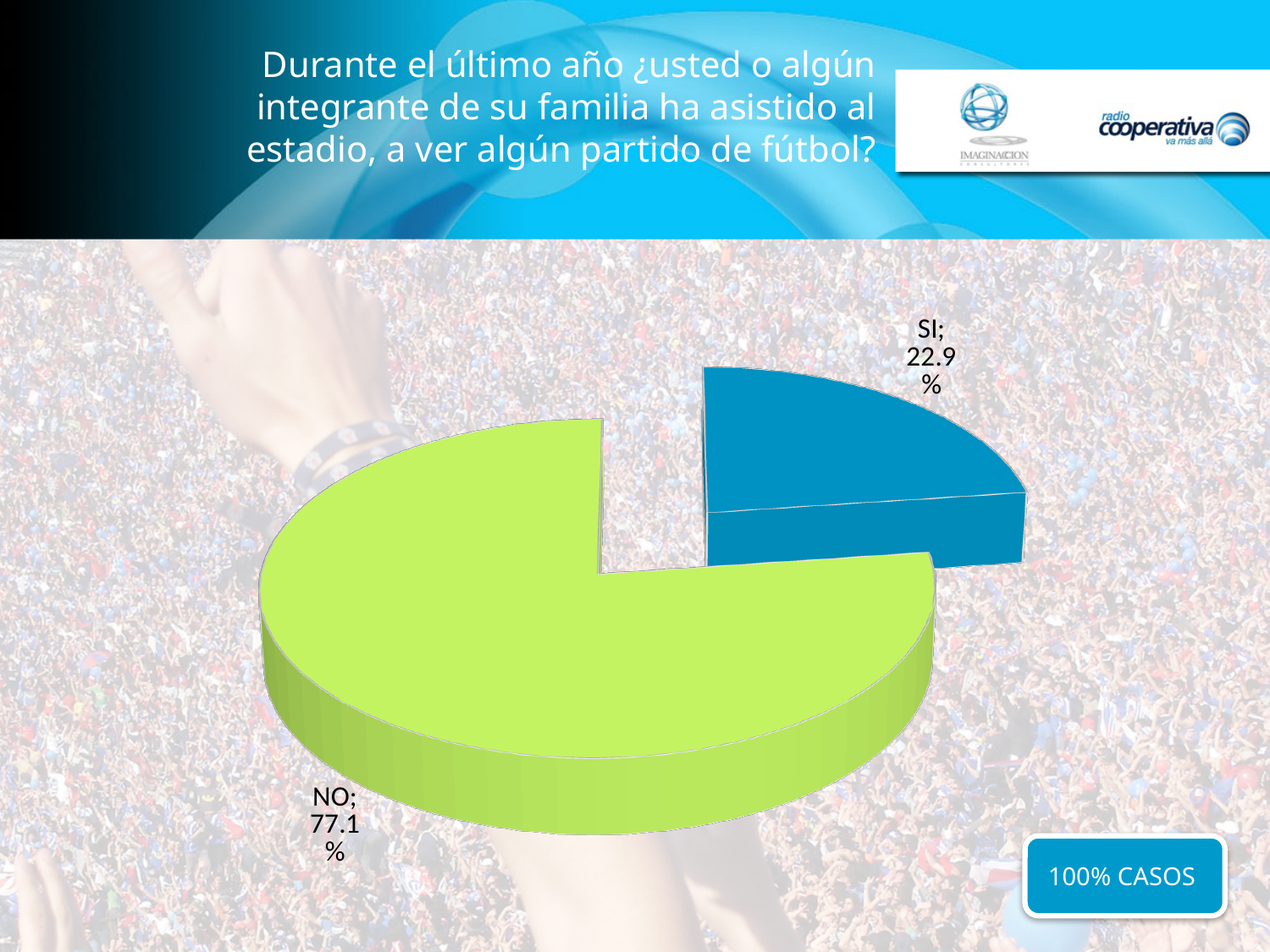
Which category has the largest share of the pie? NO What colour is the SI slice? blue How many slices does the pie chart have? 2 Which is larger, the share for SI or the share for NO? NO What colour is the NO slice? green What is the difference in percentage points between NO and SI? 54.2 What kind of chart is shown on the slide? pie chart What is the total of the two slices shown? 100% What percentage of respondents answered NO? 77.1% Which category has the smallest share of the pie? SI What percentage of respondents answered SI? 22.9%